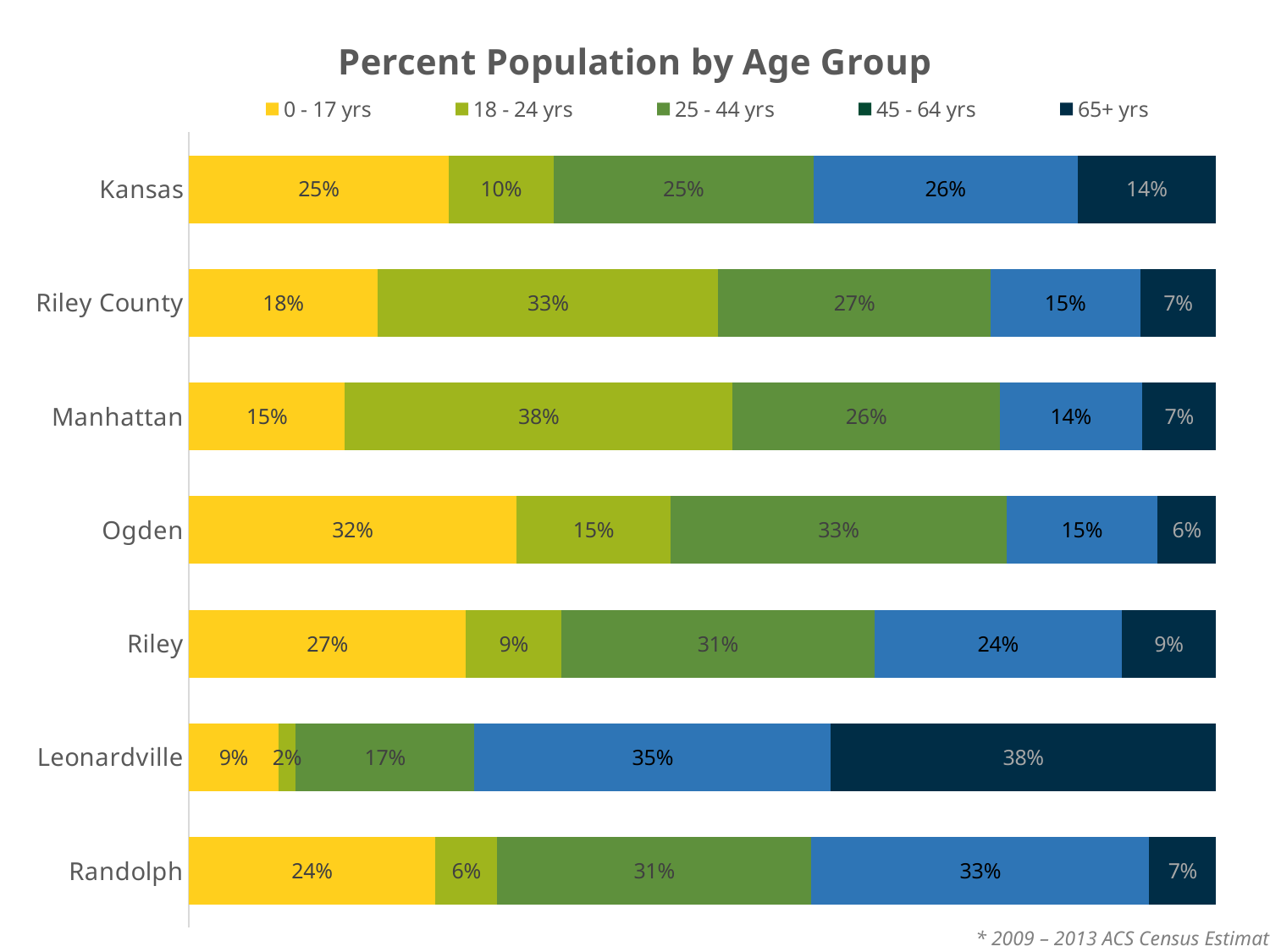
What is the value for the 65+ yrs age group in Leonardville? 38% Which location has the highest value for the 0 - 17 yrs age group? Ogden What share of Ogden's population is 0 - 17 yrs? 32% What is the total of the stacked bar for Kansas? 100% How much larger is the 18 - 24 yrs value for Riley County than for Kansas? 23 percentage points What type of chart is shown on the slide? Stacked bar chart What percentage of Manhattan's population is in the 18 - 24 yrs age group? 38% Which has a larger 45 - 64 yrs value, Randolph or Riley? Randolph How many age groups does the legend list? 5 Which location has the lowest value for the 18 - 24 yrs age group? Leonardville How many locations are shown on the chart? 7 What is the title of the chart? Percent Population by Age Group